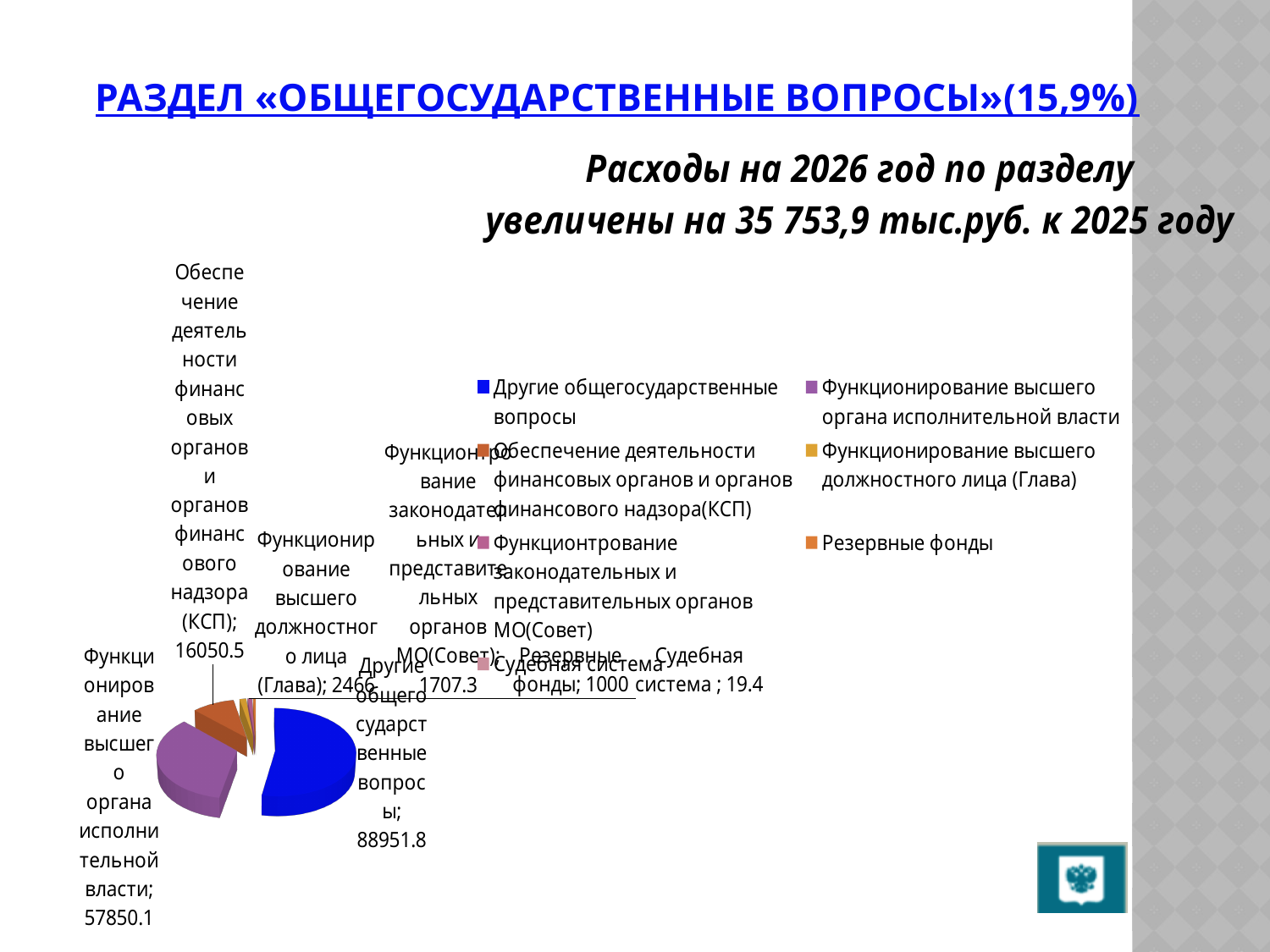
What is the value for «Резервные фонды»? 1000 What is the value for «Обеспечение деятельности финансовых органов и органов финансового надзора (КСП)»? 16050.5 What is the value for «Другие общегосударственные вопросы» in the pie chart? 88951.8 Which category has the largest slice in the pie chart? Другие общегосударственные вопросы Which is larger: «Функционирование высшего должностного лица (Глава)» or «Функционирование законодательных и представительных органов МО(Совет)»? Функционирование высшего должностного лица (Глава) How many entries does the legend list? 7 Which category has the smallest value in the pie chart? Судебная система How many categories are shown in the pie chart? 7 What is the difference between «Другие общегосударственные вопросы» and «Функционирование высшего органа исполнительной власти»? 31101.7 What is the value for «Судебная система»? 19.4 What is the value for «Функционирование высшего органа исполнительной власти»? 57850.1 What kind of chart is shown on the slide? Pie chart